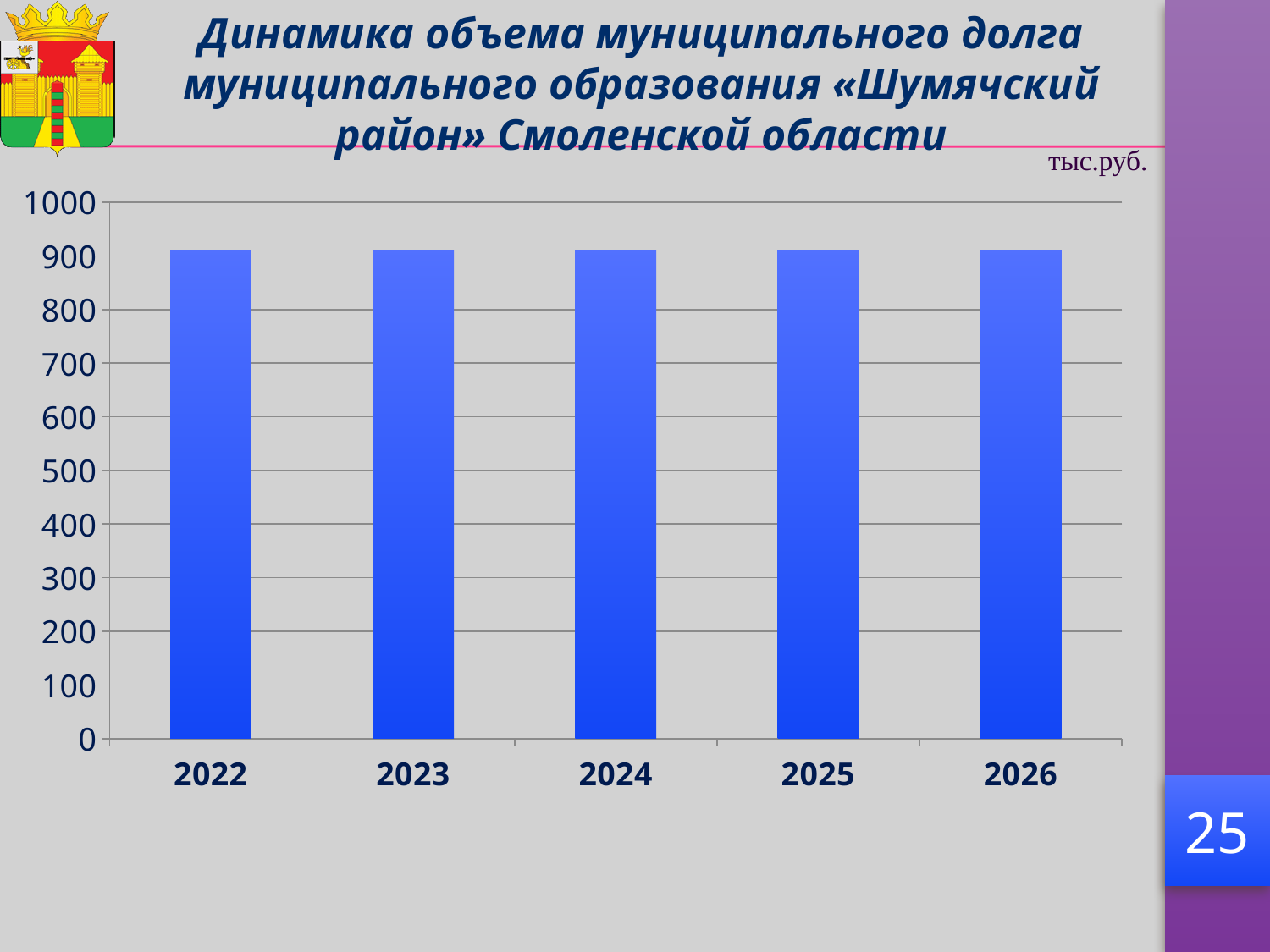
What unit of measurement is indicated above the chart? тыс.руб. Is the value for 2022 greater or less than 800? greater Is the value for 2026 greater or less than 500? greater Is the value for 2025 greater or less than 1000? less What is the first year shown on the x axis? 2022 What type of chart is shown on the slide? bar chart What is the maximum value shown on the y axis? 1000 How many years (categories) are shown on the x axis of the chart? 5 Do the values rise, fall, or stay flat from 2022 to 2026? stay flat